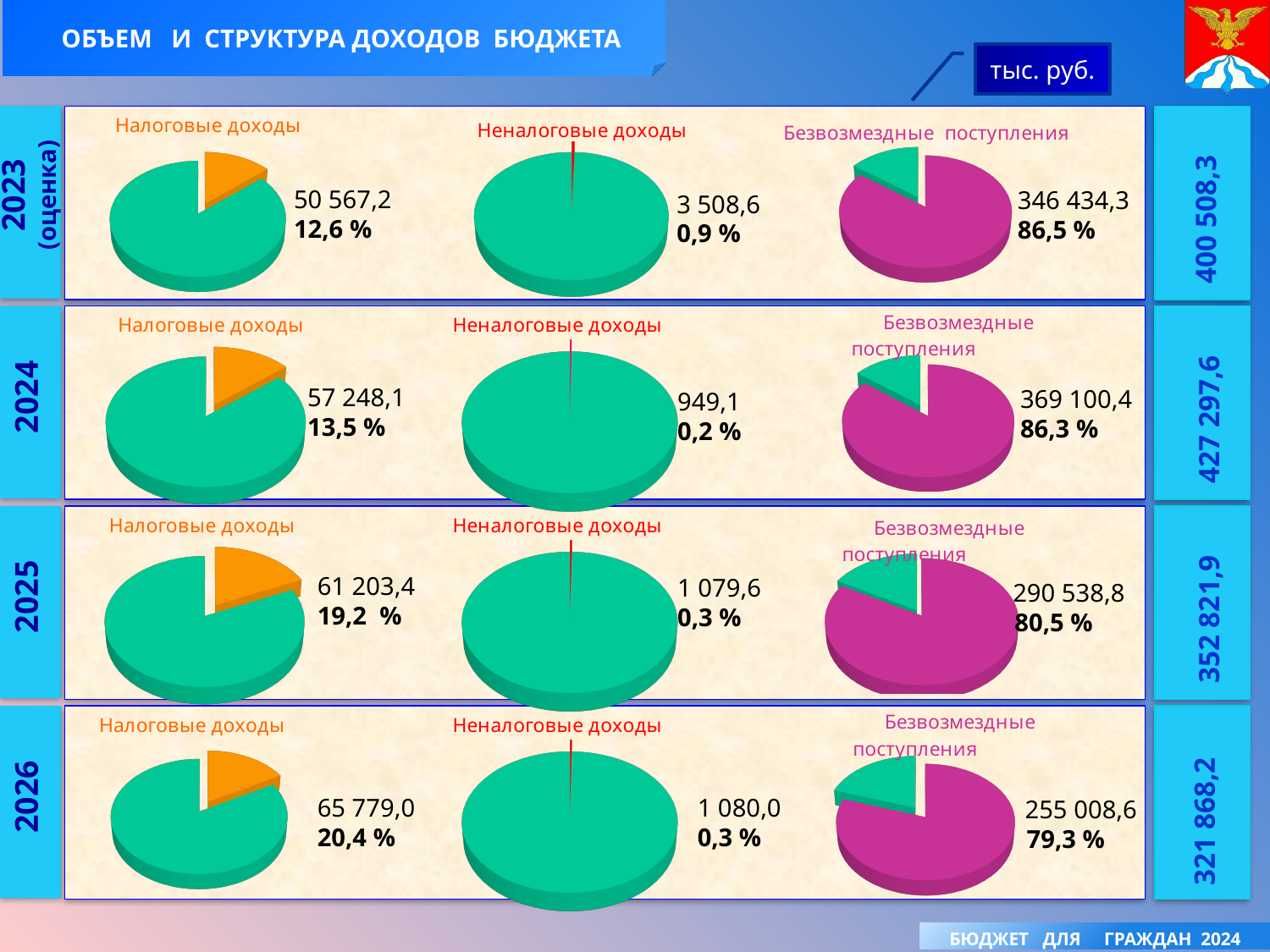
What total is shown on the right for the 2025 row? 352 821,9 What unit is indicated in the box at the top right of the slide? тыс. руб. In the 2025 row, what value is shown for Неналоговые доходы? 1 079,6 In the 2026 row, what share of the pie does Налоговые доходы represent? 20,4 % Across the rows 2023 to 2026, does the Налоговые доходы share rise or fall? Rise What is the difference between the Безвозмездные поступления values for 2024 and 2025? 78 561,6 Which is larger: the Налоговые доходы value for 2026 or for 2023 (оценка)? 2026 Which year has the lowest Неналоговые доходы value? 2024 How many pie charts are on the slide? 12 In the 2024 row, what share of the pie does Безвозмездные поступления represent? 86,3 % What kind of charts are shown on the slide? Pie charts In the 2023 (оценка) row, what value is shown for Налоговые доходы? 50 567,2